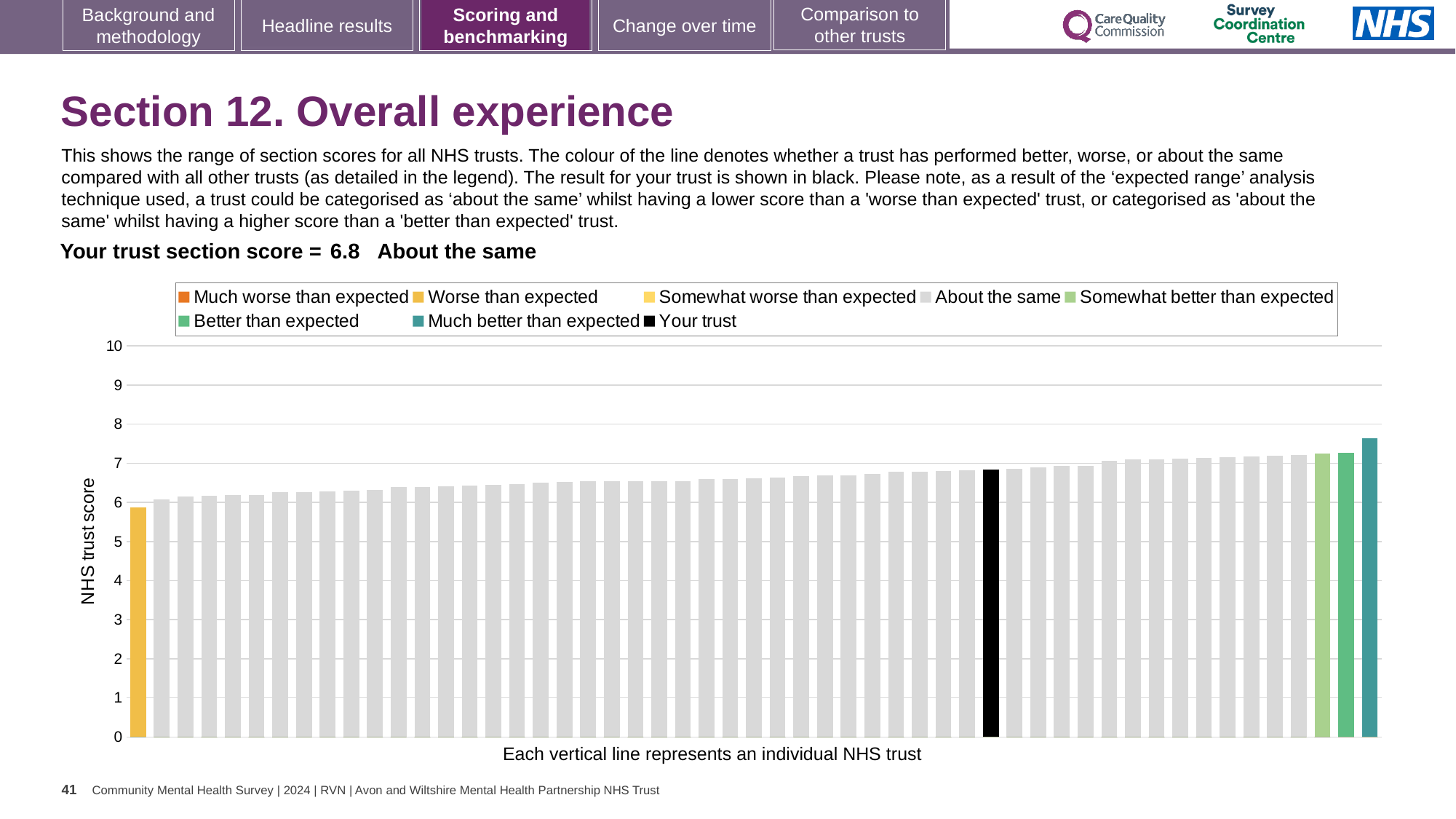
How many entries does the chart legend list? 8 Is the value for the tallest bar (the rightmost, teal bar) greater or less than 7? greater Is the value for your trust (the black bar) greater or less than 7? less Which is larger: the value for your trust (black bar) or the value for the leftmost yellow bar? your trust Which legend category does the tallest bar belong to? Much better than expected Do the bar values rise or fall from left to right along the x axis? rise What is the highest value shown on the vertical axis? 10 What kind of chart is shown on the slide? bar chart What is the section score for your trust shown on the slide? 6.8 Which legend category does the shortest bar belong to? Worse than expected Is the value for the leftmost (yellow) bar greater or less than 7? less What is the label on the vertical axis of the chart? NHS trust score